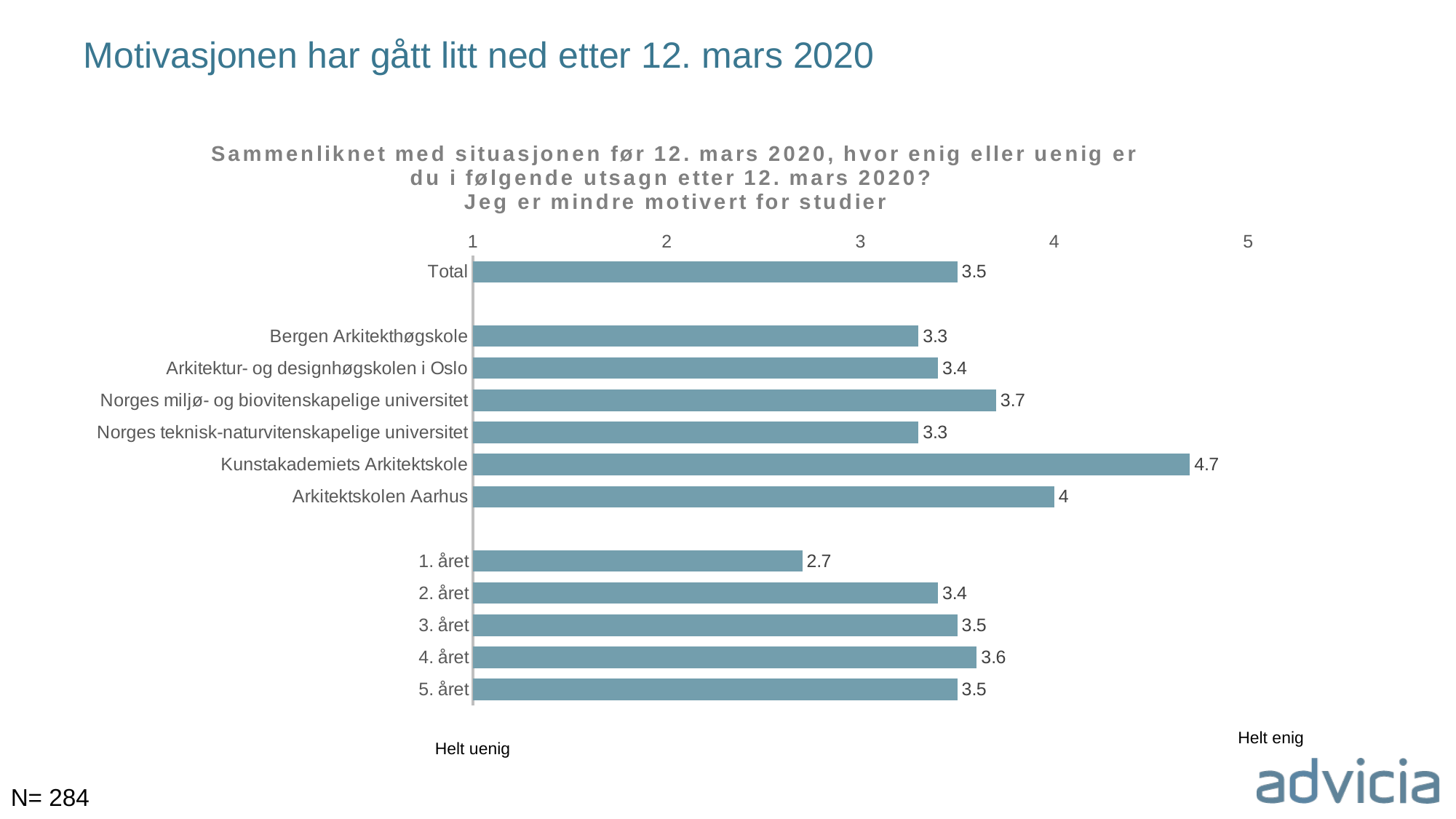
What is the value for Kunstakademiets Arkitektskole? 4.7 What is the value for 1. året? 2.7 What is the sample size (N) stated on the slide? 284 How many bars are plotted in the chart? 12 Which is larger, the value for 4. året or the value for 2. året? 4. året Which category has the highest value? Kunstakademiets Arkitektskole What is the difference between the values for Kunstakademiets Arkitektskole and Arkitektskolen Aarhus? 0.7 Which category has the lowest value? 1. året What is the value for Total? 3.5 What is the value for Norges miljø- og biovitenskapelige universitet? 3.7 Is the value for Arkitektskolen Aarhus greater or less than 3? greater What kind of chart is shown on the slide? bar chart